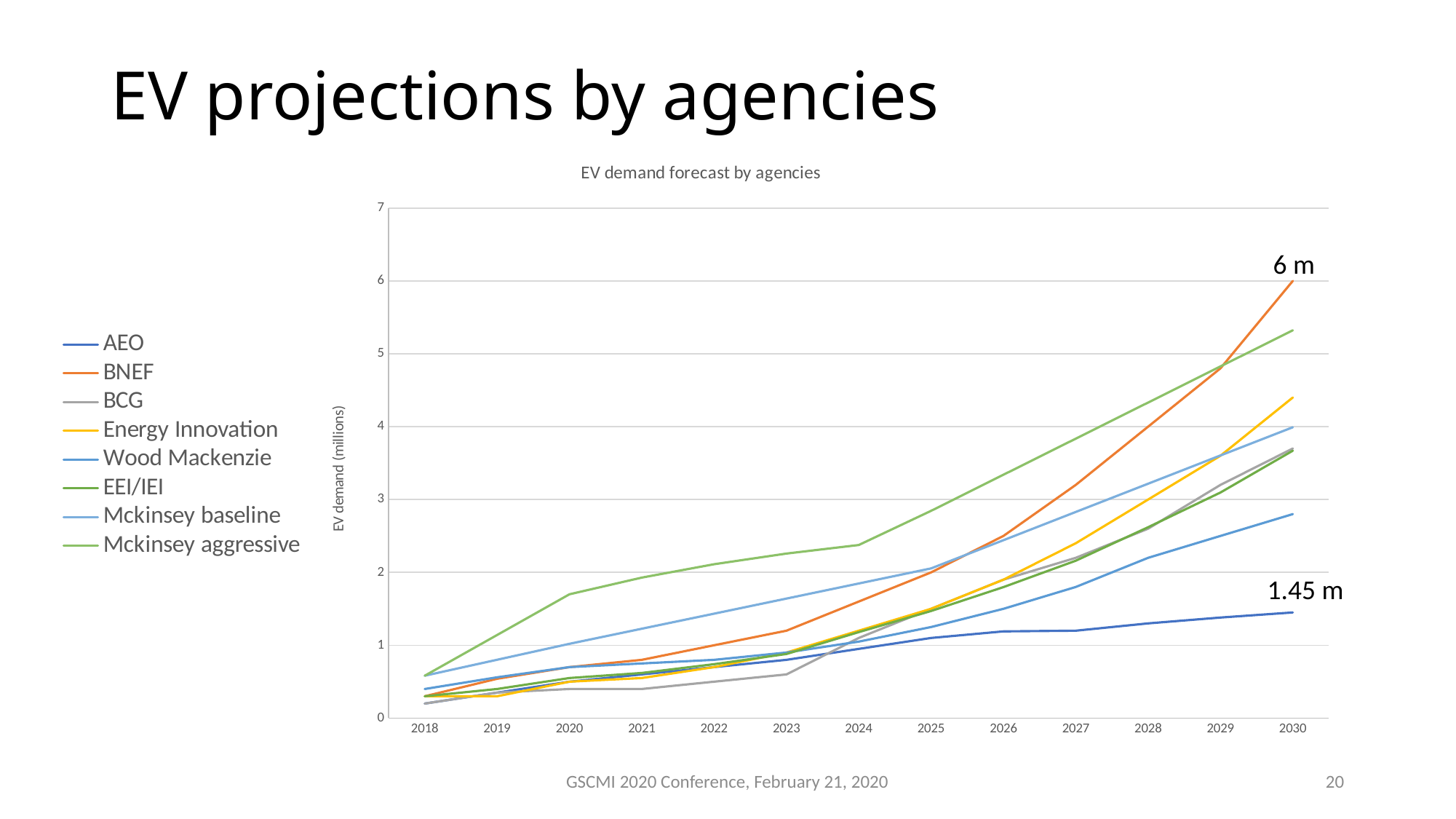
In 2030, which is larger: Mckinsey baseline or Wood Mackenzie? Mckinsey baseline What is the difference between the labelled 2030 values for BNEF and AEO? 4.55 m What kind of chart is shown on the slide? line chart What is the title of the y axis? EV demand (millions) Which agency has the highest projected EV demand in 2030? BNEF Is the value for Mckinsey aggressive in 2030 greater or less than 5? greater How many years are plotted along the x axis? 13 Which agency has the lowest projected EV demand in 2030? AEO How many series does the legend list? 8 What is the labelled value for AEO in 2030? 1.45 m Is the value for Wood Mackenzie in 2030 greater or less than 3? less What is the labelled value for BNEF in 2030? 6 m